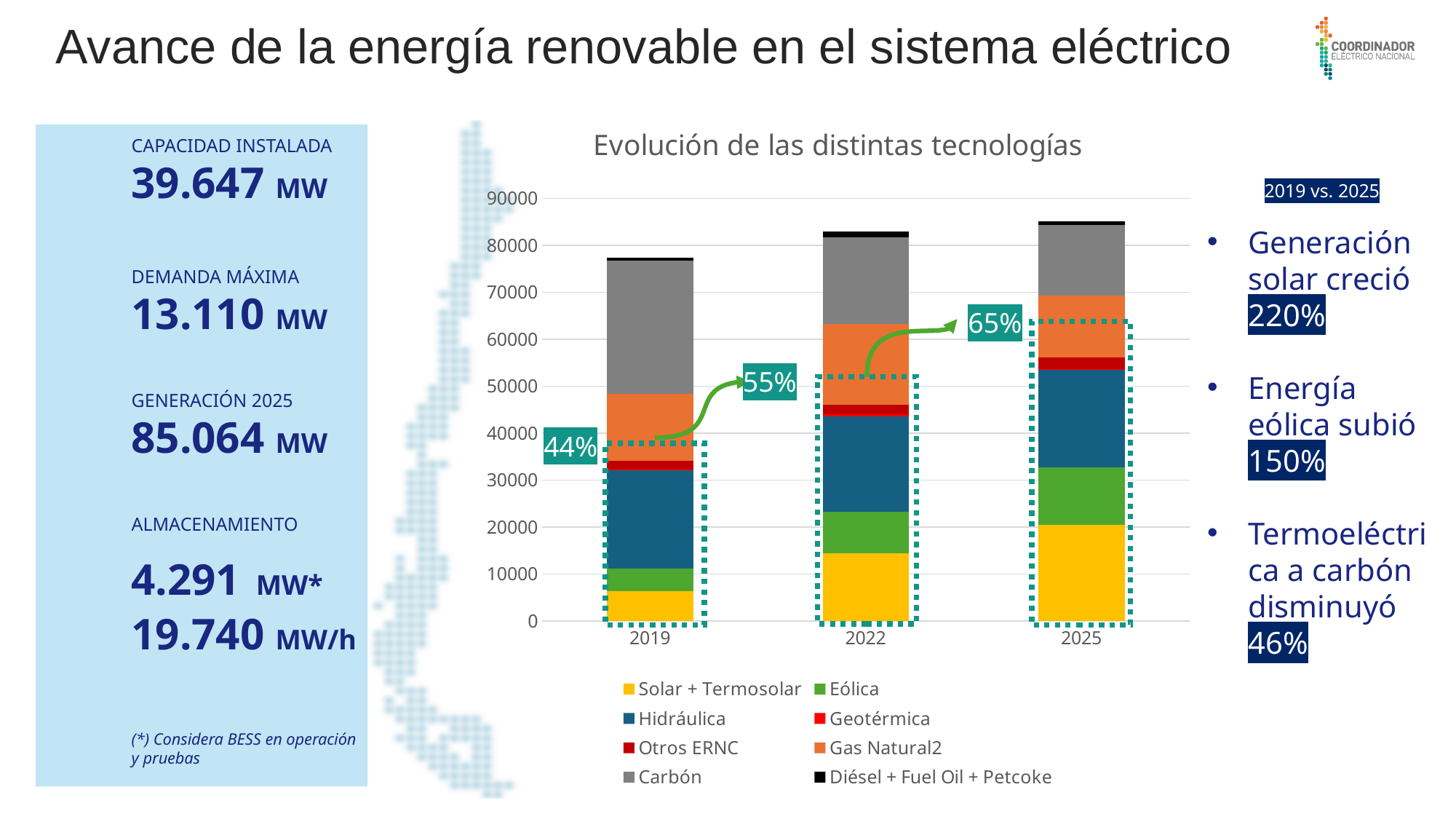
What percentage label is shown next to the dashed box on the 2025 bar? 65% What is the title of the chart? Evolución de las distintas tecnologías Is the total height of the 2019 bar greater or less than 80000? less How many years (categories) are plotted on the x axis of the chart? 3 Is the Solar + Termosolar segment for 2019 greater or less than 10000? less Do the total bar heights rise or fall from 2019 to 2025? Rise Which year has the shortest stacked bar in the chart? 2019 What kind of chart is shown under the title 'Evolución de las distintas tecnologías'? Stacked bar chart How many series does the chart legend list? 8 Is the Solar + Termosolar segment larger in 2019 or in 2025? 2025 Which year has the tallest stacked bar in the chart? 2025 Is the total height of the 2025 bar greater or less than 80000? greater